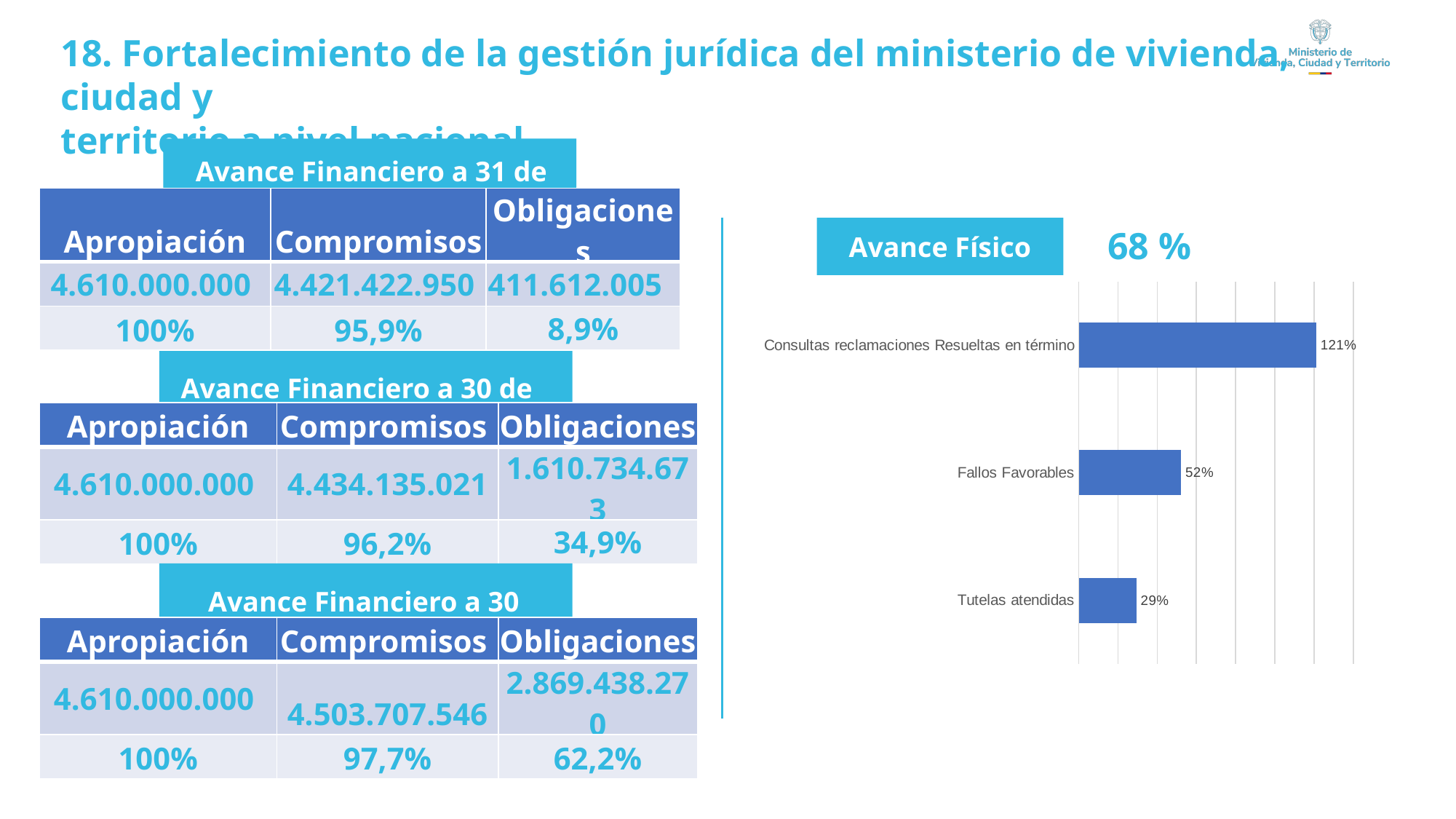
What overall percentage is shown next to the Avance Físico title? 68 % What is the title shown above the bar chart? Avance Físico What kind of chart is shown on the right side of the slide? Bar chart What is the value for Tutelas atendidas in the bar chart? 29% How many categories are shown in the bar chart? 3 Which category has the highest value in the bar chart? Consultas reclamaciones Resueltas en término Which is larger in the bar chart, the value for Fallos Favorables or the value for Tutelas atendidas? Fallos Favorables What is the value for Consultas reclamaciones Resueltas en término in the bar chart? 121% What is the difference between the values for Fallos Favorables and Tutelas atendidas in the bar chart? 23% Which category has the lowest value in the bar chart? Tutelas atendidas What is the difference between the values for Consultas reclamaciones Resueltas en término and Fallos Favorables in the bar chart? 69% What is the value for Fallos Favorables in the bar chart? 52%